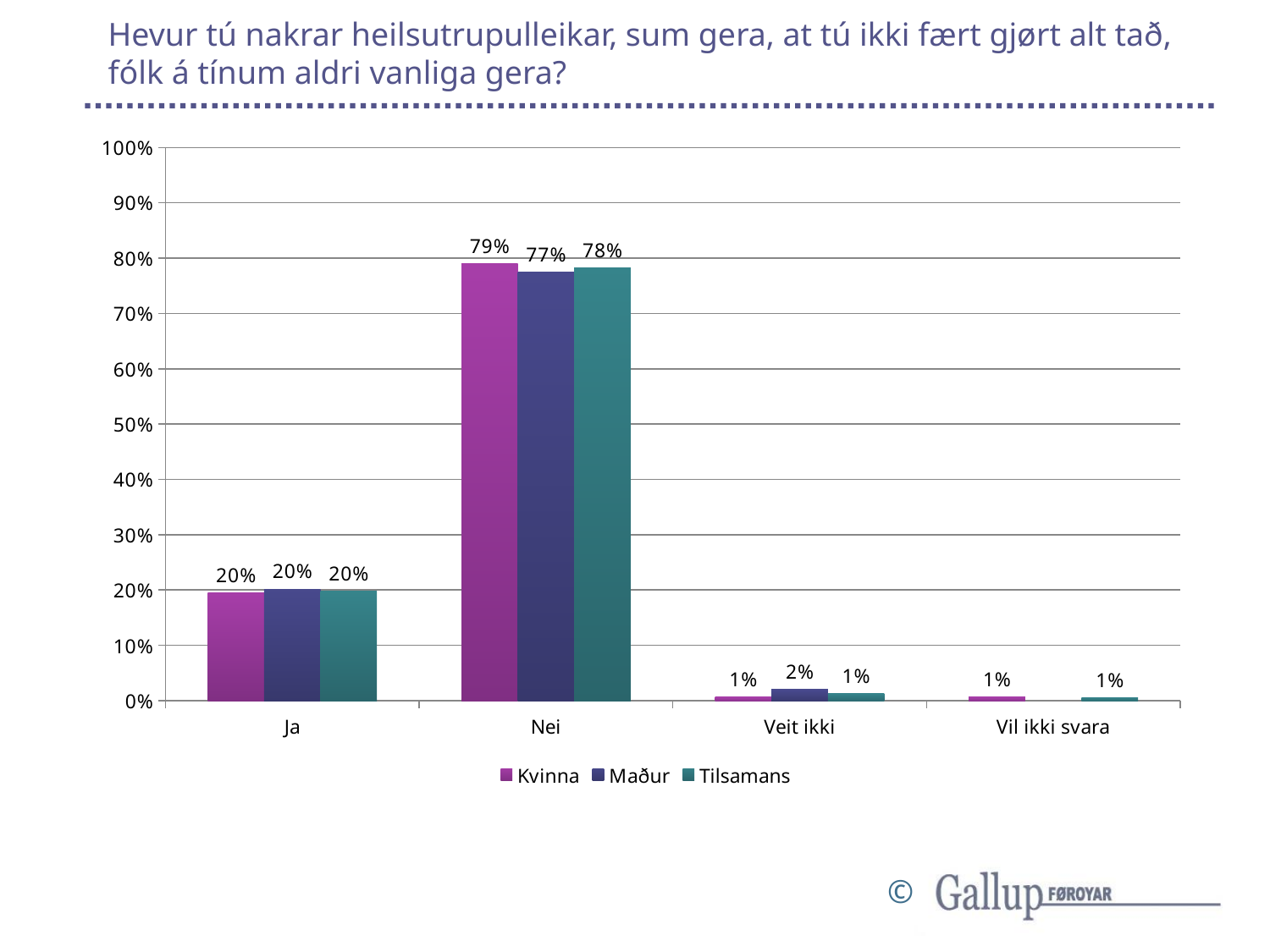
Which category has the highest value for Tilsamans? Nei Which is larger in the Nei category, the Kvinna value or the Maður value? Kvinna What is the value for Maður in the Veit ikki category? 2% How many categories are shown on the x axis? 4 What is the value for Maður in the Nei category? 77% How many series does the legend list? 3 Which series is shown in the teal colour in the legend? Tilsamans What kind of chart is shown on the slide? bar chart What is the difference between the Kvinna and Maður values in the Nei category? 2% What is the value for Tilsamans in the Ja category? 20% Is the Tilsamans value for Nei greater or less than 70%? greater What is the value for Kvinna in the Nei category? 79%